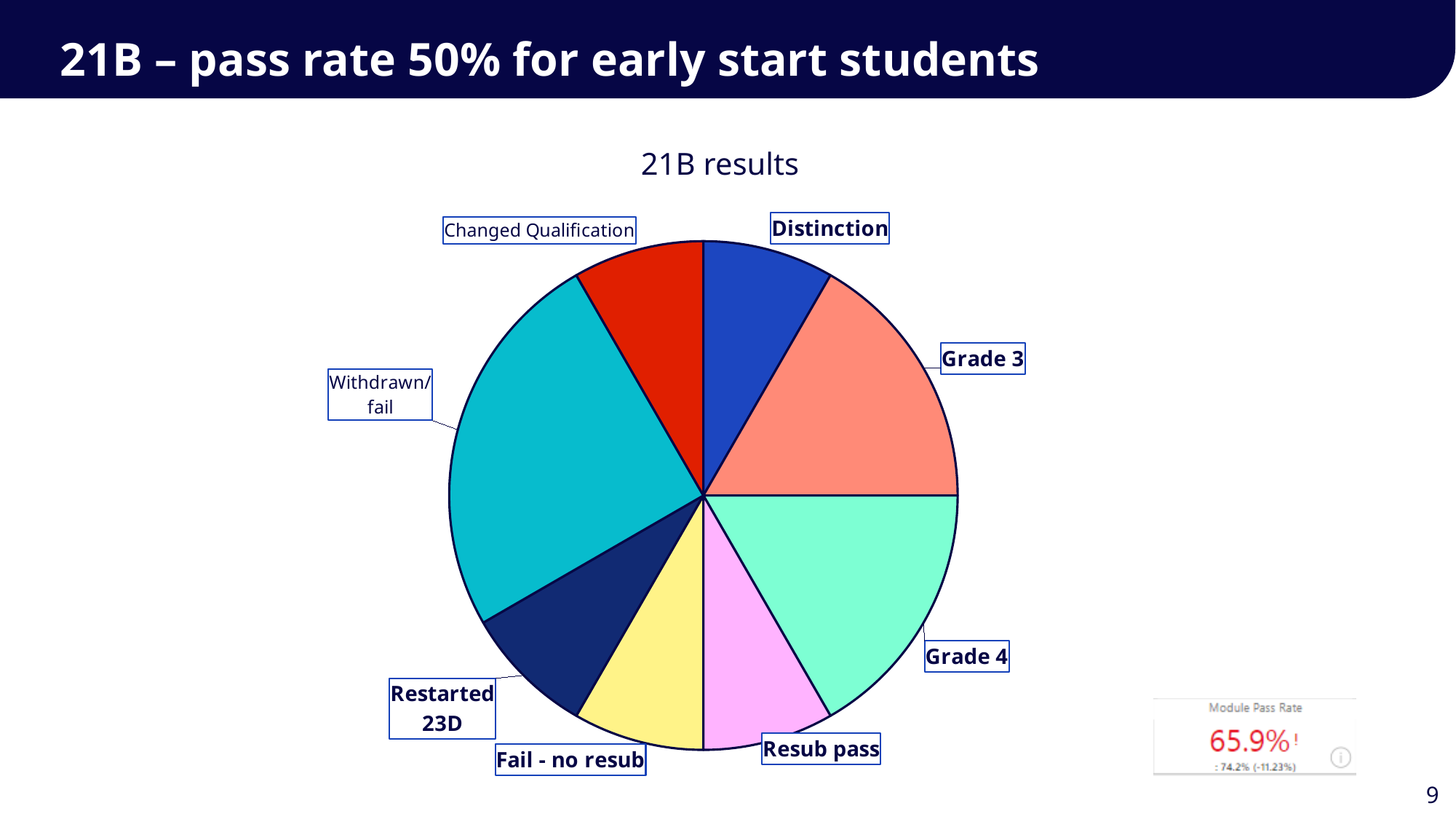
Which category has the largest slice of the pie? Withdrawn/fail What is the title of the chart? 21B results Which slice is larger, Grade 4 or Fail - no resub? Grade 4 Which slice is larger, Grade 3 or Distinction? Grade 3 How many slices does the pie chart have? 8 What colour is the Withdrawn/fail slice? teal What kind of chart is shown on the slide? pie chart Which slice is larger, Grade 4 or Resub pass? Grade 4